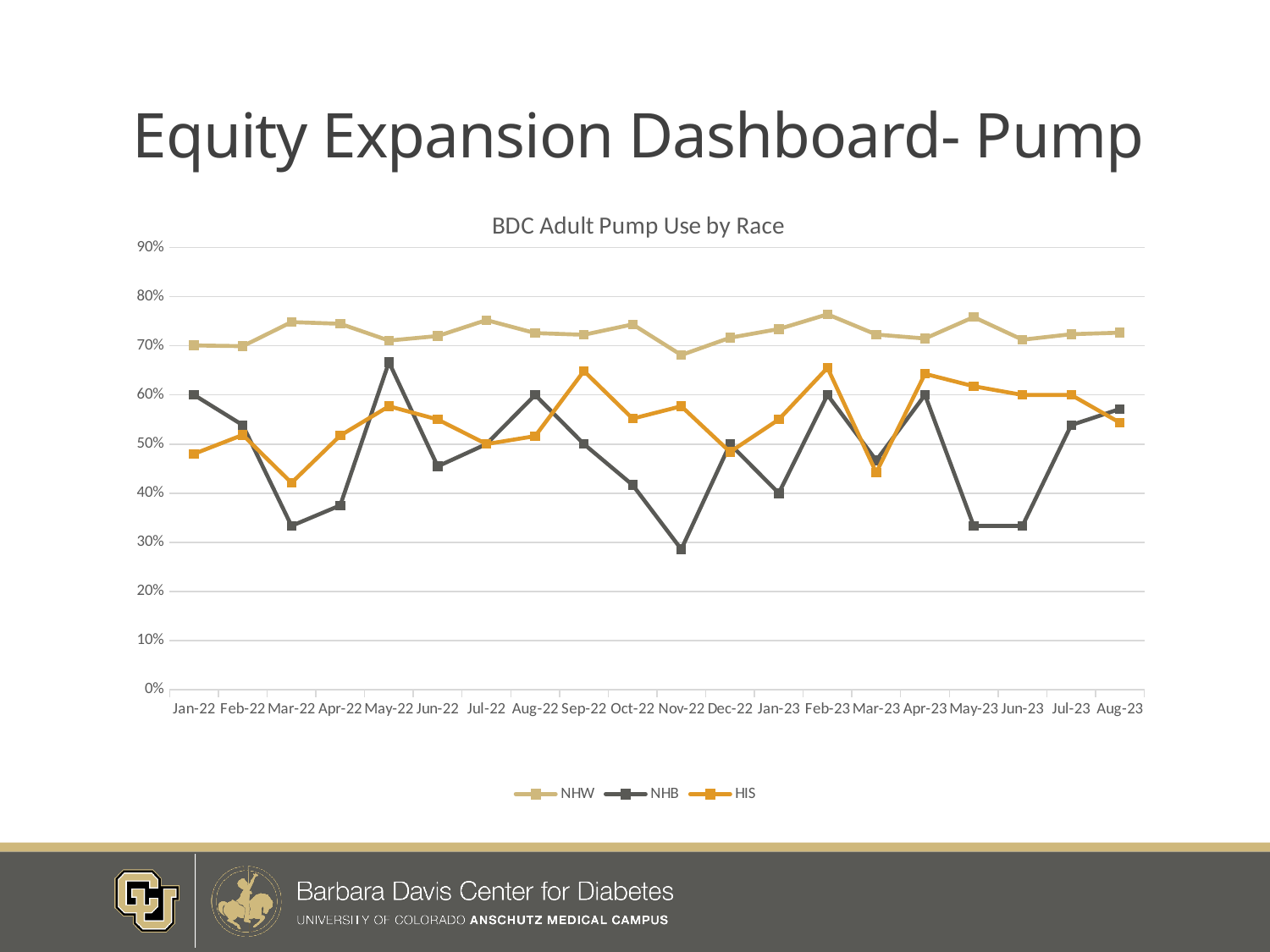
How many months are plotted along the x axis? 20 In Jan-22, which series has the larger value, NHB or HIS? NHB What is the title of the chart? BDC Adult Pump Use by Race Is the NHB value for Nov-22 greater or less than 30%? less Is the HIS value for Jan-22 greater or less than 50%? less In which month does the NHB series reach its lowest value? Nov-22 In May-23, which series has the larger value, NHB or HIS? HIS What are the names of the series in the legend? NHW, NHB, HIS What kind of chart is shown on the slide? Line chart Is the NHW value for Feb-23 greater or less than 70%? greater How many series does the legend list? 3